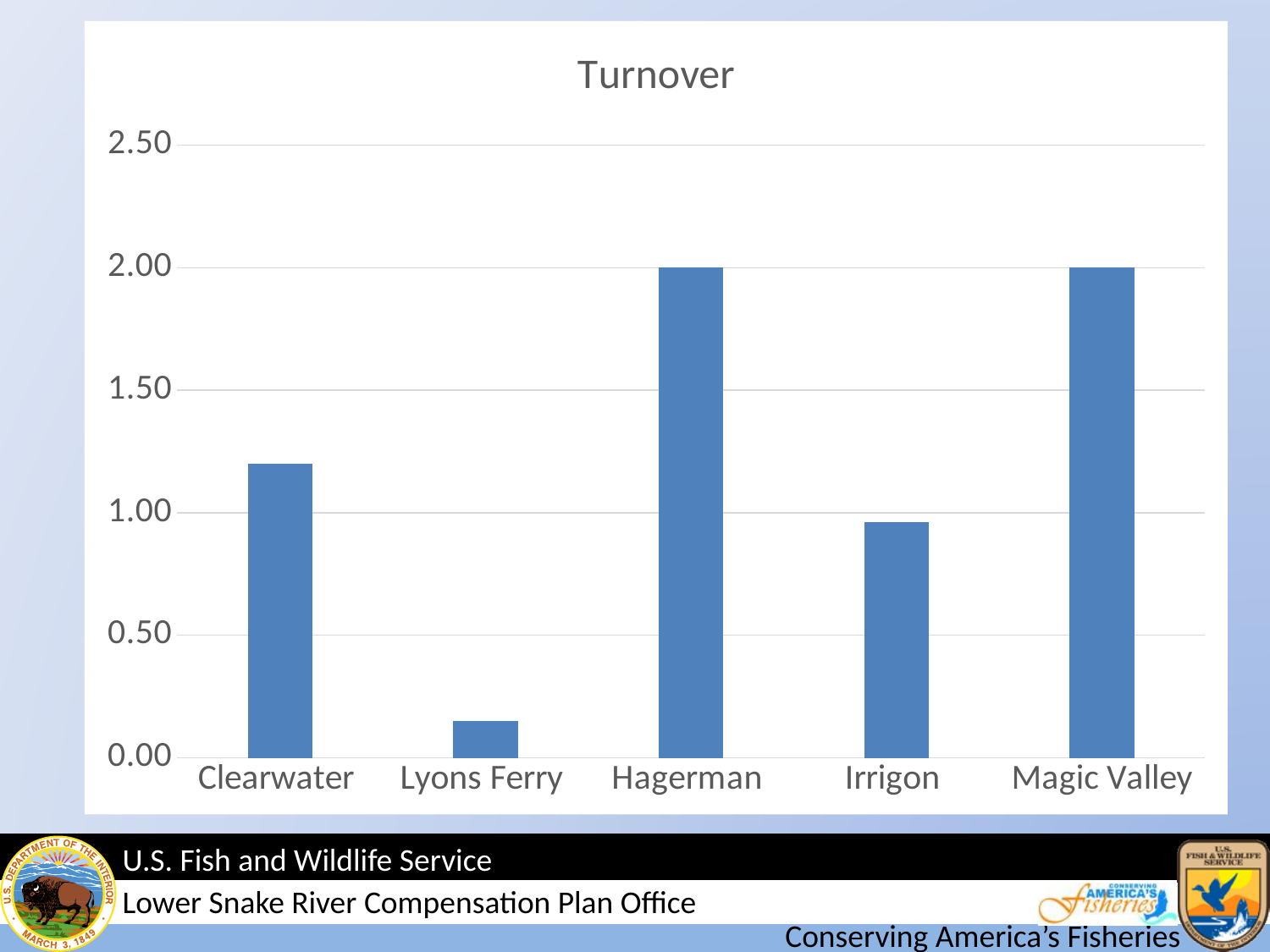
How many categories are shown on the x axis of the chart? 5 What is the value for Magic Valley? 2.00 Is the value for Lyons Ferry greater or less than 0.50? less Which category has the lowest value? Lyons Ferry What is the title of the chart? Turnover What is the difference between the values for Hagerman and Magic Valley? 0.00 What kind of chart is shown on the slide? bar chart What is the value for Hagerman? 2.00 Is the value for Clearwater greater or less than 1.00? greater Is the value for Irrigon greater or less than 0.50? greater Which is larger, the value for Hagerman or the value for Lyons Ferry? Hagerman Which is larger, the value for Clearwater or the value for Irrigon? Clearwater